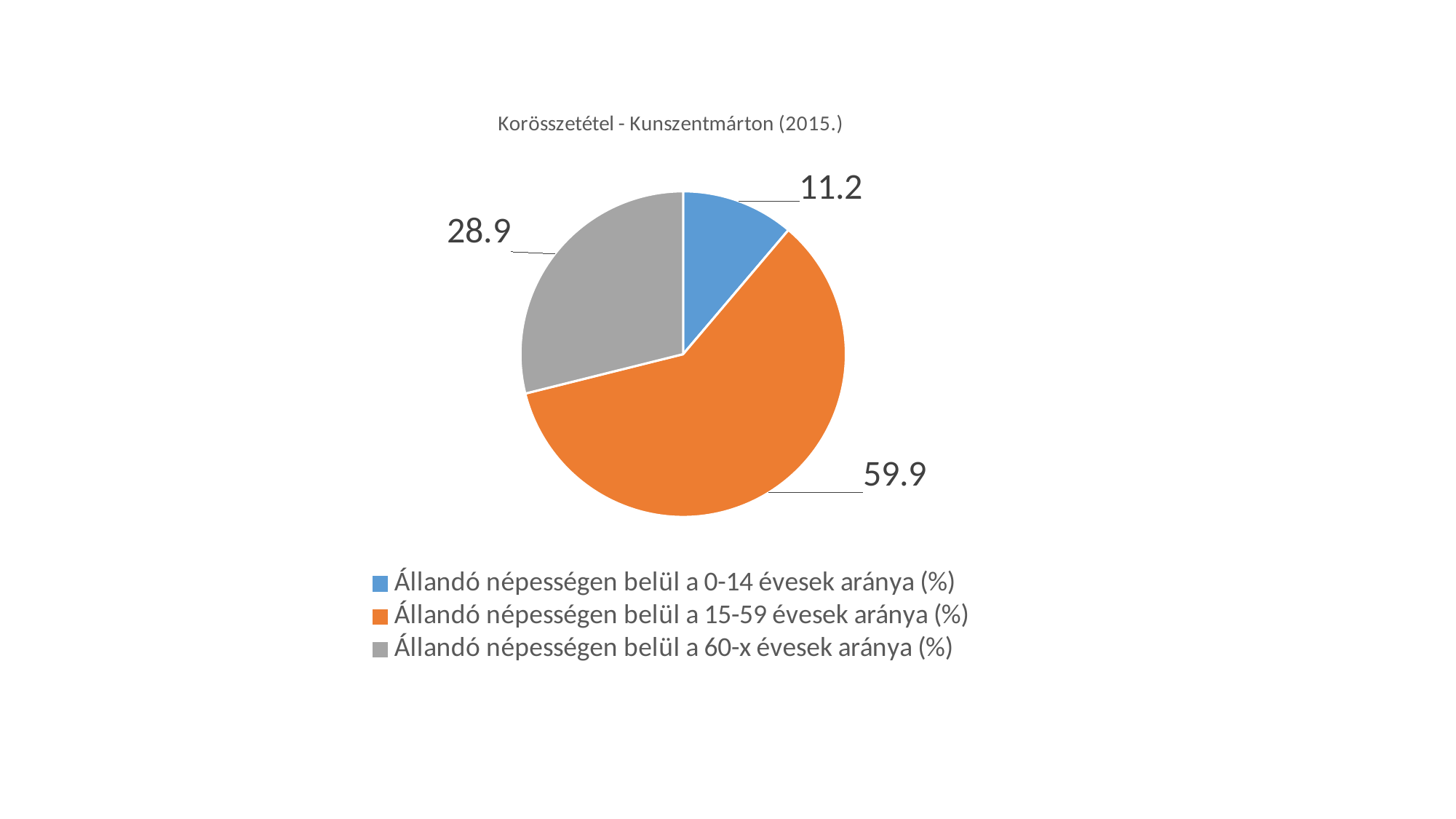
What colour is the slice for 'Állandó népességen belül a 15-59 évesek aránya (%)'? orange What is the value for 'Állandó népességen belül a 15-59 évesek aránya (%)'? 59.9 Which is larger: the value for the 60-x age group or the value for the 0-14 age group? Állandó népességen belül a 60-x évesek aránya (%) What is the difference between the value for the 15-59 age group and the value for the 60-x age group? 31.0 How many slices does the pie chart have? 3 What type of chart is shown on the slide? pie chart Which category has the largest slice of the pie? Állandó népességen belül a 15-59 évesek aránya (%) What is the value for 'Állandó népességen belül a 60-x évesek aránya (%)'? 28.9 Which category has the smallest slice of the pie? Állandó népességen belül a 0-14 évesek aránya (%) What is the title of the chart? Korösszetétel - Kunszentmárton (2015.) What is the value for 'Állandó népességen belül a 0-14 évesek aránya (%)'? 11.2 What is the difference between the value for the 60-x age group and the value for the 0-14 age group? 17.7